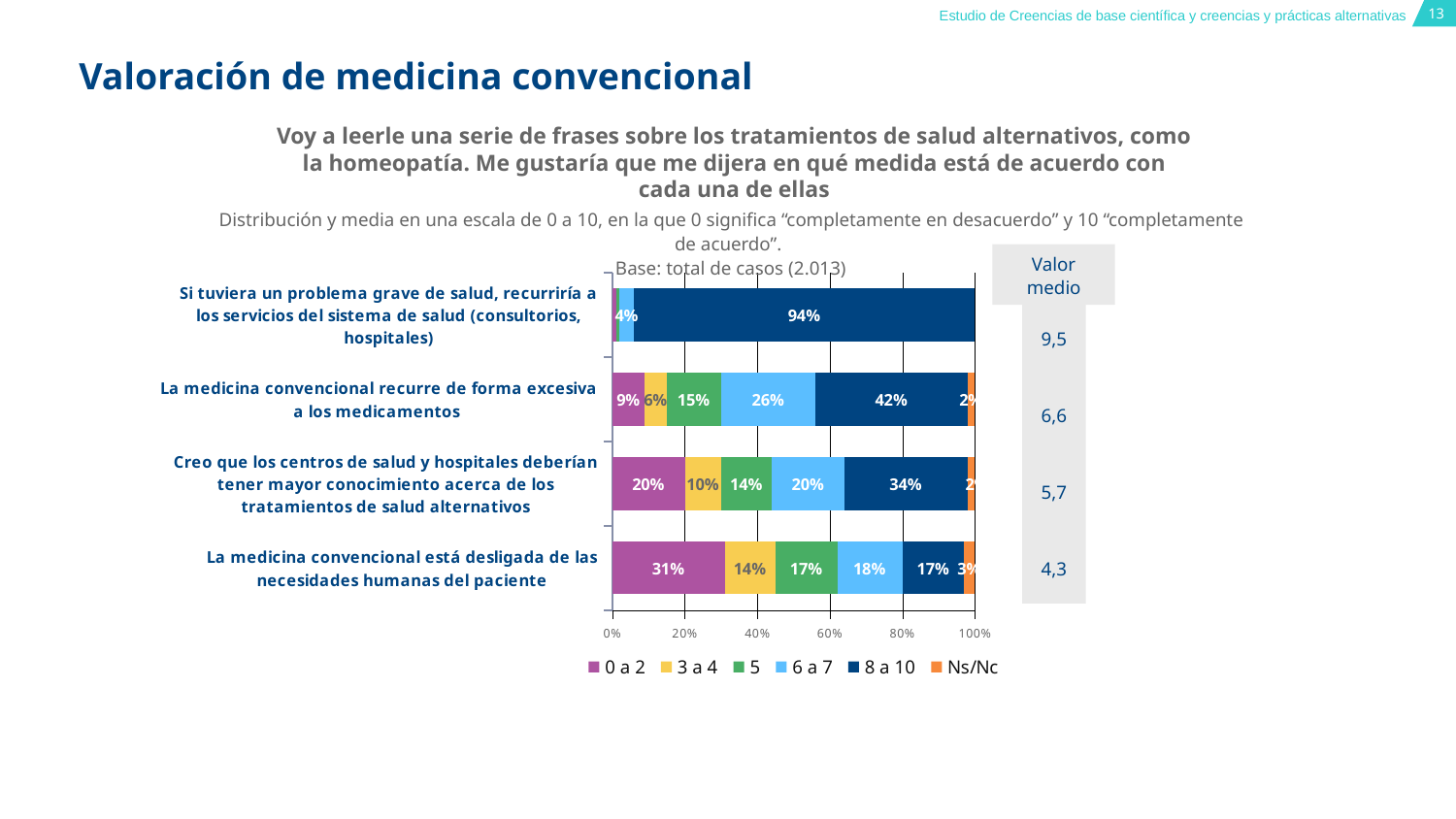
What is the value of the '0 a 2' segment for 'La medicina convencional está desligada de las necesidades humanas del paciente'? 31% What is the value of the '8 a 10' segment for 'Si tuviera un problema grave de salud, recurriría a los servicios del sistema de salud (consultorios, hospitales)'? 94% Which statement has the lowest 'Valor medio'? La medicina convencional está desligada de las necesidades humanas del paciente What kind of chart is shown on the slide? stacked bar chart What is the value of the '8 a 10' segment for 'La medicina convencional recurre de forma excesiva a los medicamentos'? 42% What is the difference between the '8 a 10' share for 'La medicina convencional recurre de forma excesiva a los medicamentos' and for 'Creo que los centros de salud y hospitales deberían tener mayor conocimiento acerca de los tratamientos de salud alternativos'? 8% How many series does the legend list? 6 What is the value of the '6 a 7' segment for 'Creo que los centros de salud y hospitales deberían tener mayor conocimiento acerca de los tratamientos de salud alternativos'? 20% What is the 'Valor medio' for 'La medicina convencional recurre de forma excesiva a los medicamentos'? 6,6 Which is larger: the '0 a 2' share for 'La medicina convencional está desligada de las necesidades humanas del paciente' or for 'Creo que los centros de salud y hospitales deberían tener mayor conocimiento acerca de los tratamientos de salud alternativos'? La medicina convencional está desligada de las necesidades humanas del paciente How many statements (categories) are plotted in the chart? 4 Which statement has the highest '8 a 10' share? Si tuviera un problema grave de salud, recurriría a los servicios del sistema de salud (consultorios, hospitales)